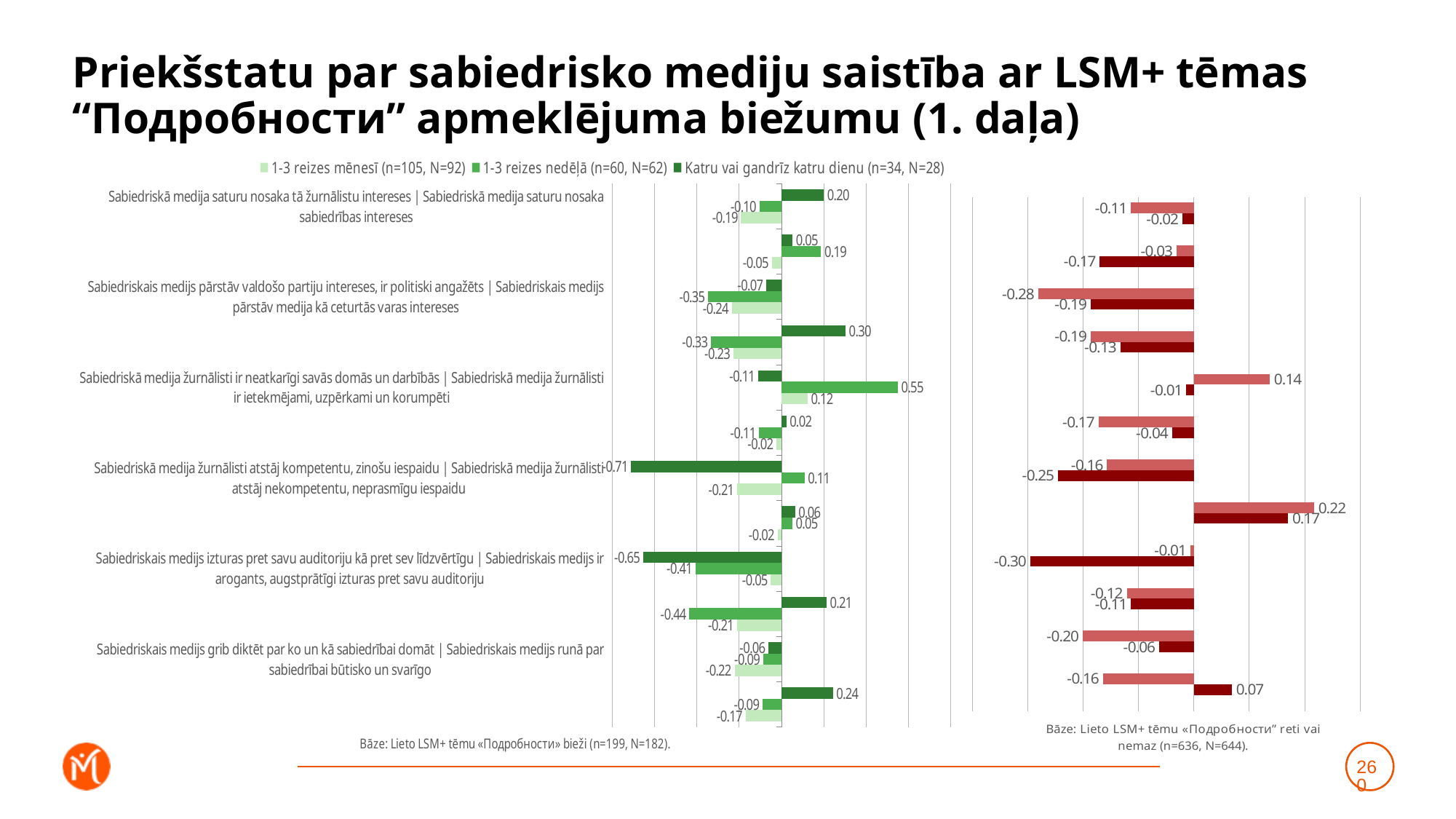
In the left chart, what is the value of 'Katru vai gandrīz katru dienu' for 'Sabiedriskā medija saturu nosaka tā žurnālistu intereses | Sabiedriskā medija saturu nosaka sabiedrības intereses'? 0.20 What base (Bāze) note is printed under the left chart? Lieto LSM+ tēmu «Подробности» bieži (n=199, N=182). In the left chart, for 'Sabiedriskais medijs grib diktēt par ko un kā sabiedrībai domāt | Sabiedriskais medijs runā par sabiedrībai būtisko un svarīgo', which series has the lowest value? 1-3 reizes mēnesī In the left chart, what is the highest value shown across all bars? 0.55 In the left chart, for 'Sabiedriskais medijs izturas pret savu auditoriju kā pret sev līdzvērtīgu | Sabiedriskais medijs ir arogants, augstprātīgi izturas pret savu auditoriju', what is the difference between the 'Katru vai gandrīz katru dienu' value and the '1-3 reizes nedēļā' value? 0.24 How many series does the legend of the left chart list? 3 In the left chart, what is the value of '1-3 reizes nedēļā' for 'Sabiedriskais medijs pārstāv valdošo partiju intereses, ir politiski angažēts | Sabiedriskais medijs pārstāv medija kā ceturtās varas intereses'? -0.35 In the left chart, what is the value of 'Katru vai gandrīz katru dienu' for 'Sabiedriskā medija žurnālisti atstāj kompetentu, zinošu iespaidu | Sabiedriskā medija žurnālisti atstāj nekompetentu, neprasmīgu iespaidu'? -0.71 In the left chart, what is the value of '1-3 reizes mēnesī' for 'Sabiedriskā medija žurnālisti ir neatkarīgi savās domās un darbībās | Sabiedriskā medija žurnālisti ir ietekmējami, uzpērkami un korumpēti'? 0.12 What kind of chart is the left chart on the slide? bar chart In the right chart, what is the lowest value shown across all bars? -0.30 In the left chart, what is the lowest value shown across all bars? -0.71